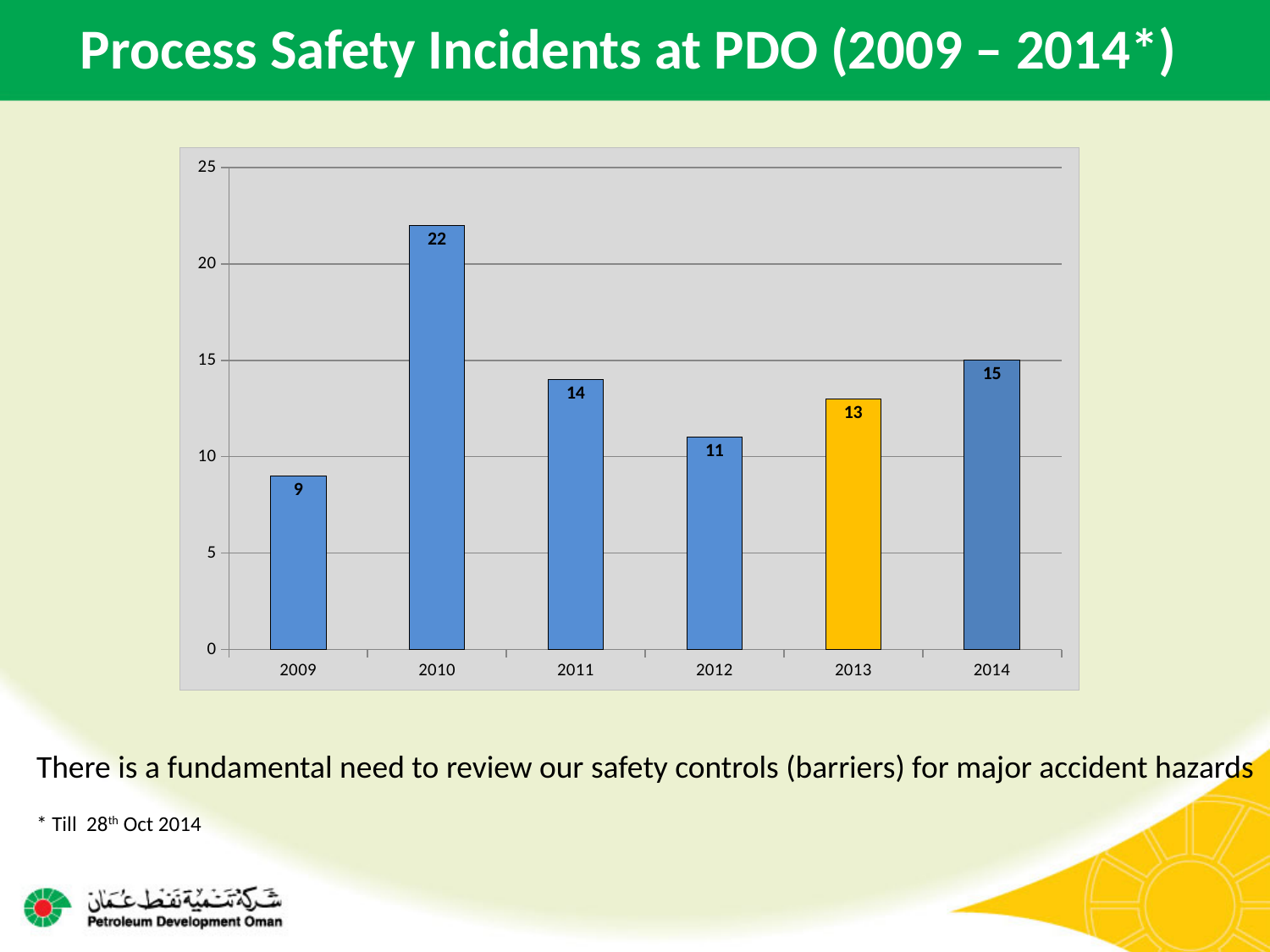
What is the difference between the values for 2010 and 2009? 13 Which year has the highest number of process safety incidents? 2010 What kind of chart is shown on the slide? Bar chart Which year has the lowest number of process safety incidents? 2009 How many years are shown on the x axis? 6 What is the difference between the values for 2014 and 2012? 4 Is the value for 2012 greater or less than 10? greater Which year has a larger value, 2011 or 2013? 2011 What is the value shown for 2009? 9 How many process safety incidents were recorded in 2010? 22 Which year's bar is coloured yellow instead of blue? 2013 What is the value shown for 2013? 13